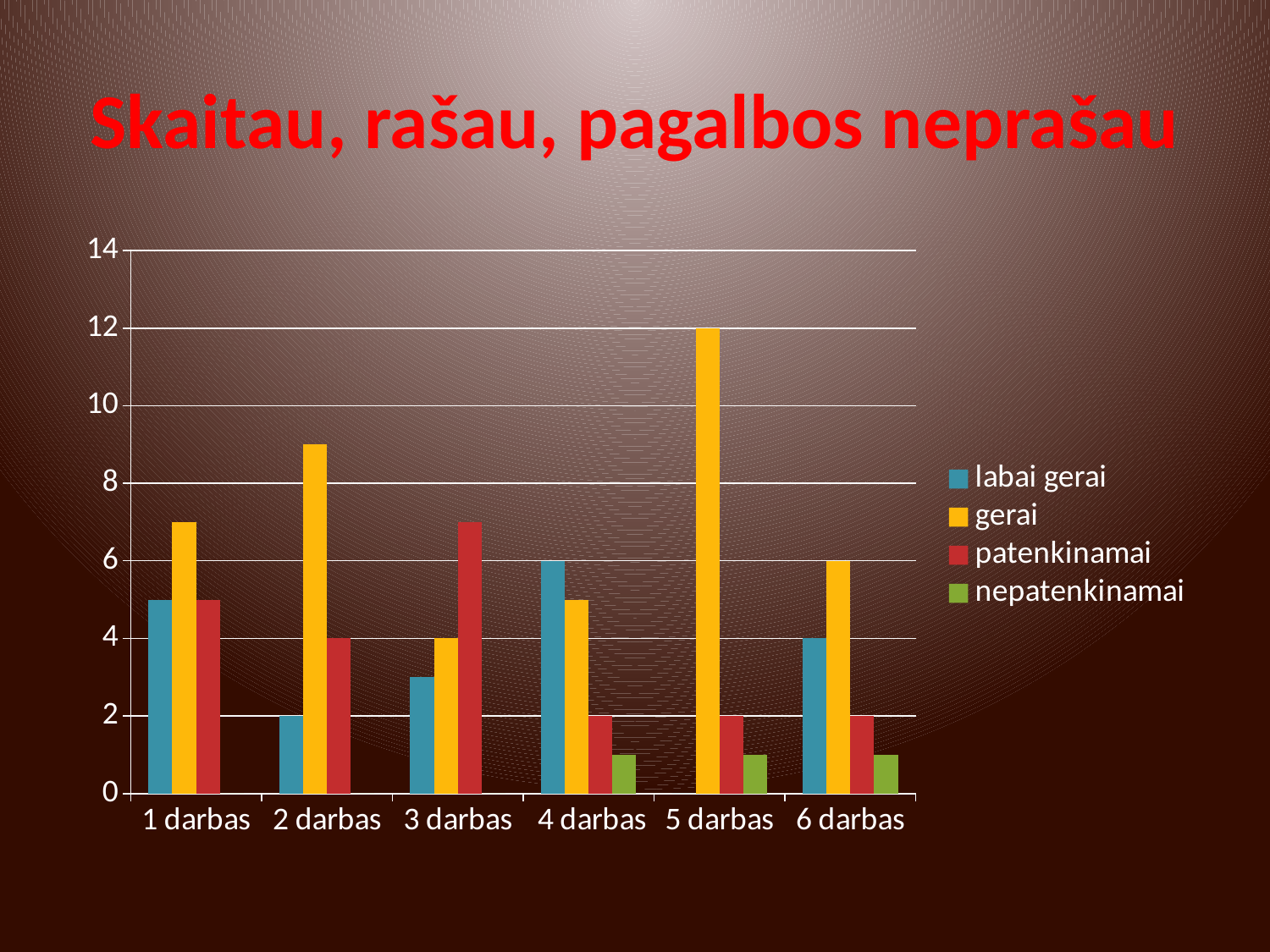
What is the value of the 'labai gerai' series for 4 darbas? 6 What is the difference between the 'gerai' and 'patenkinamai' values for 5 darbas? 10 What kind of chart is shown on the slide? bar chart Is the 'gerai' value for 2 darbas greater or less than 8? greater How many categories are shown on the x axis? 6 For which category is the 'gerai' value lowest? 3 darbas What is the value of the 'gerai' series for 5 darbas? 12 For 4 darbas, which is larger: 'labai gerai' or 'gerai'? labai gerai For which category is the 'gerai' value highest? 5 darbas How many series does the legend list? 4 What is the value of the 'patenkinamai' series for 2 darbas? 4 What is the title of the slide? Skaitau, rašau, pagalbos neprašau